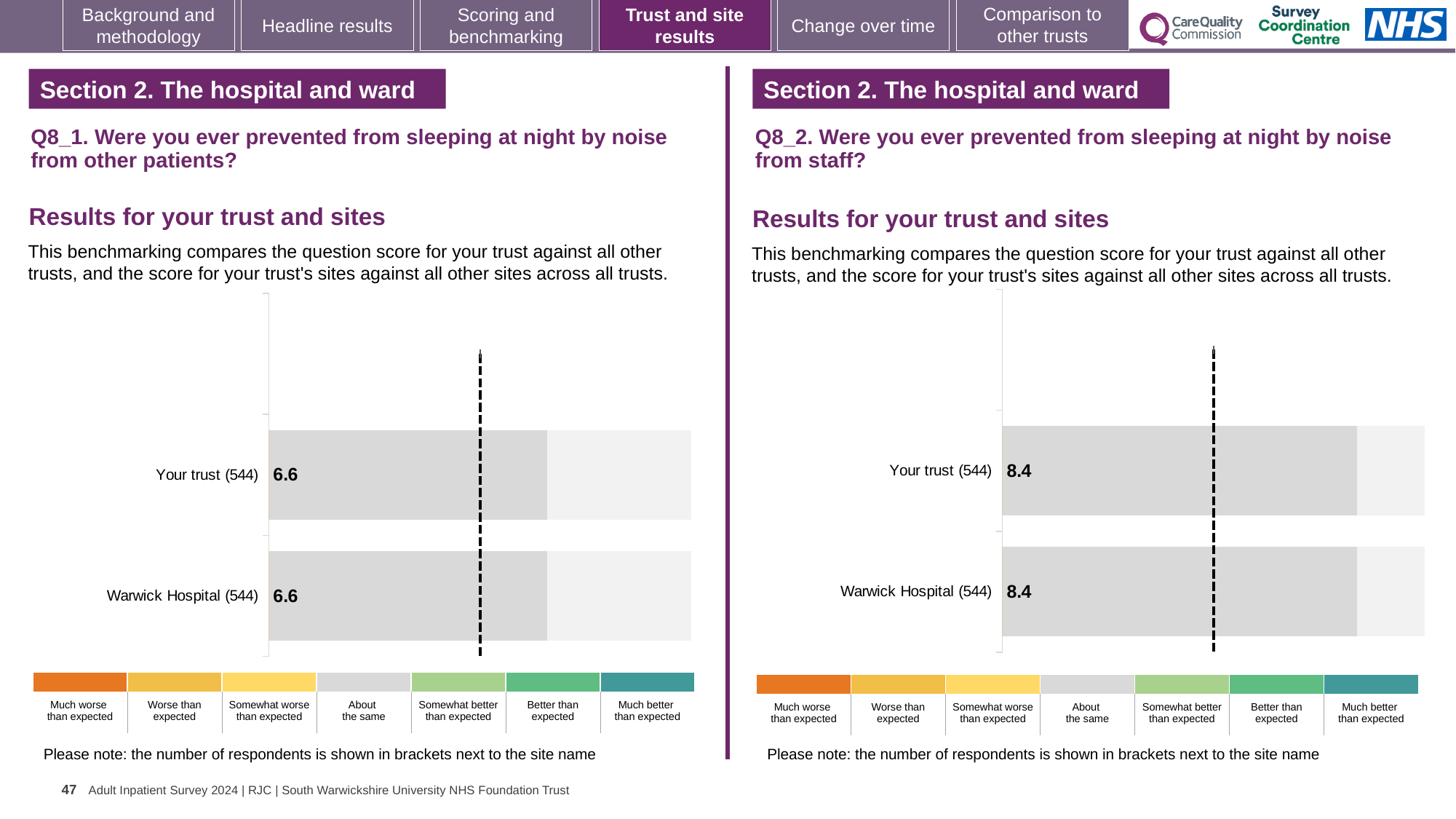
In the Q8_1 chart (noise from other patients), what is the score for Warwick Hospital? 6.6 In the Q8_2 chart (noise from staff), what is the score for Warwick Hospital? 8.4 Is the Your trust score in the Q8_2 chart (noise from staff) larger or smaller than the Your trust score in the Q8_1 chart (noise from other patients)? Larger In the Q8_1 chart (noise from other patients), how many respondents are shown in brackets next to Warwick Hospital? 544 In the Q8_1 chart (noise from other patients), what is the score for Your trust? 6.6 In the Q8_1 chart (noise from other patients), what is the difference between the Your trust score and the Warwick Hospital score? 0.0 How many bars are plotted in the Q8_1 chart (noise from other patients)? 2 In the Q8_2 chart (noise from staff), what is the score for Your trust? 8.4 What type of chart is used for the Q8_1 results (noise from other patients)? Bar chart In the Q8_2 chart (noise from staff), what is the difference between the Your trust score and the Warwick Hospital score? 0.0 How many categories does the colour key below the Q8_2 chart (noise from staff) list? 7 How many bars are plotted in the Q8_2 chart (noise from staff)? 2